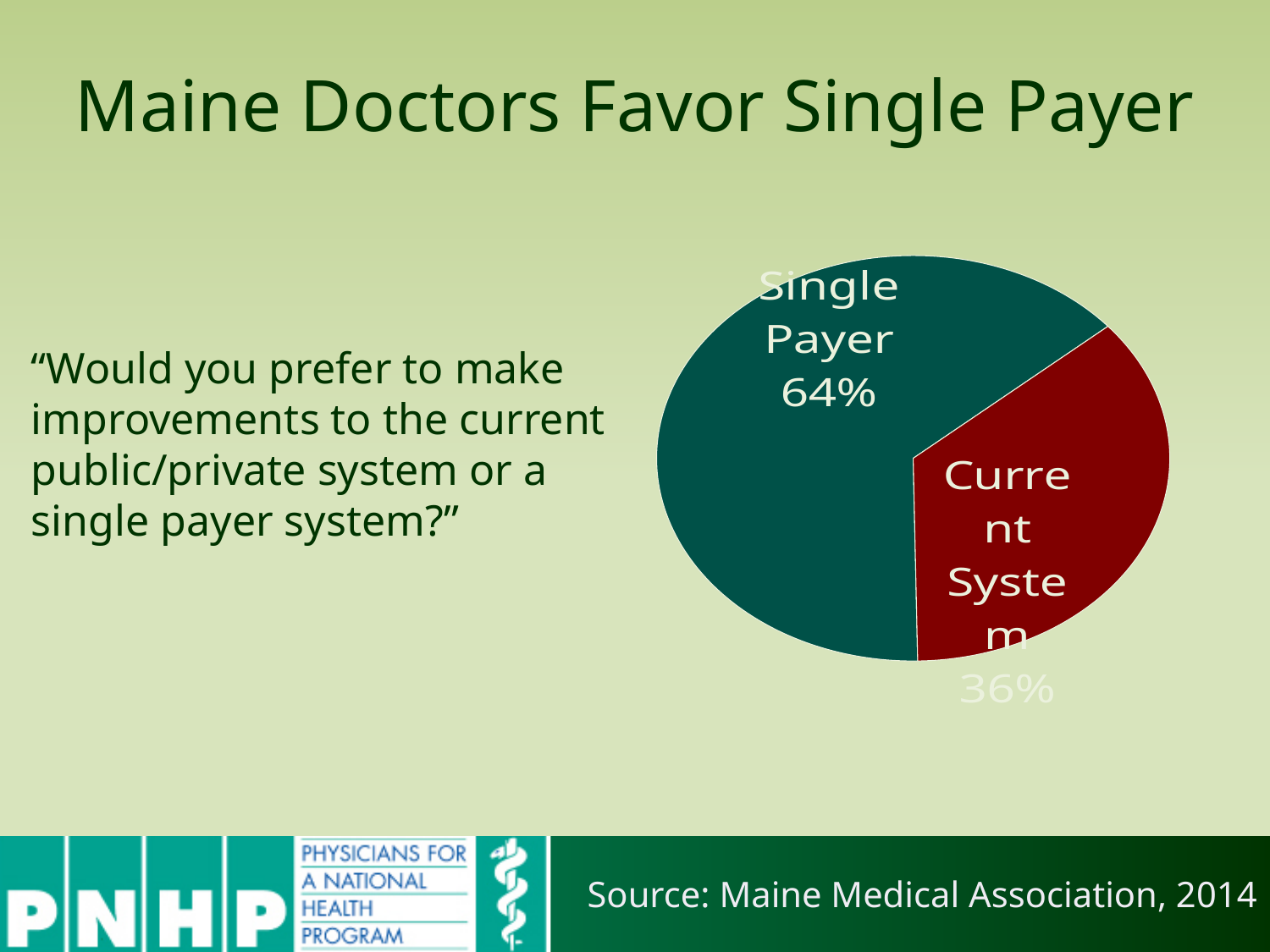
What kind of chart is shown on the slide? pie chart Which slice of the pie is the smallest? Current System What colour is the Single Payer slice? dark teal green Which slice of the pie is the largest? Single Payer What is the difference in percentage points between the Single Payer and Current System slices? 28 What colour is the Current System slice? dark red Which is larger, the Single Payer slice or the Current System slice? Single Payer What is the total of the two slices shown in the pie chart? 100% What share of the pie does Current System represent? 36% How many slices does the pie chart have? 2 What share of the pie does Single Payer represent? 64%